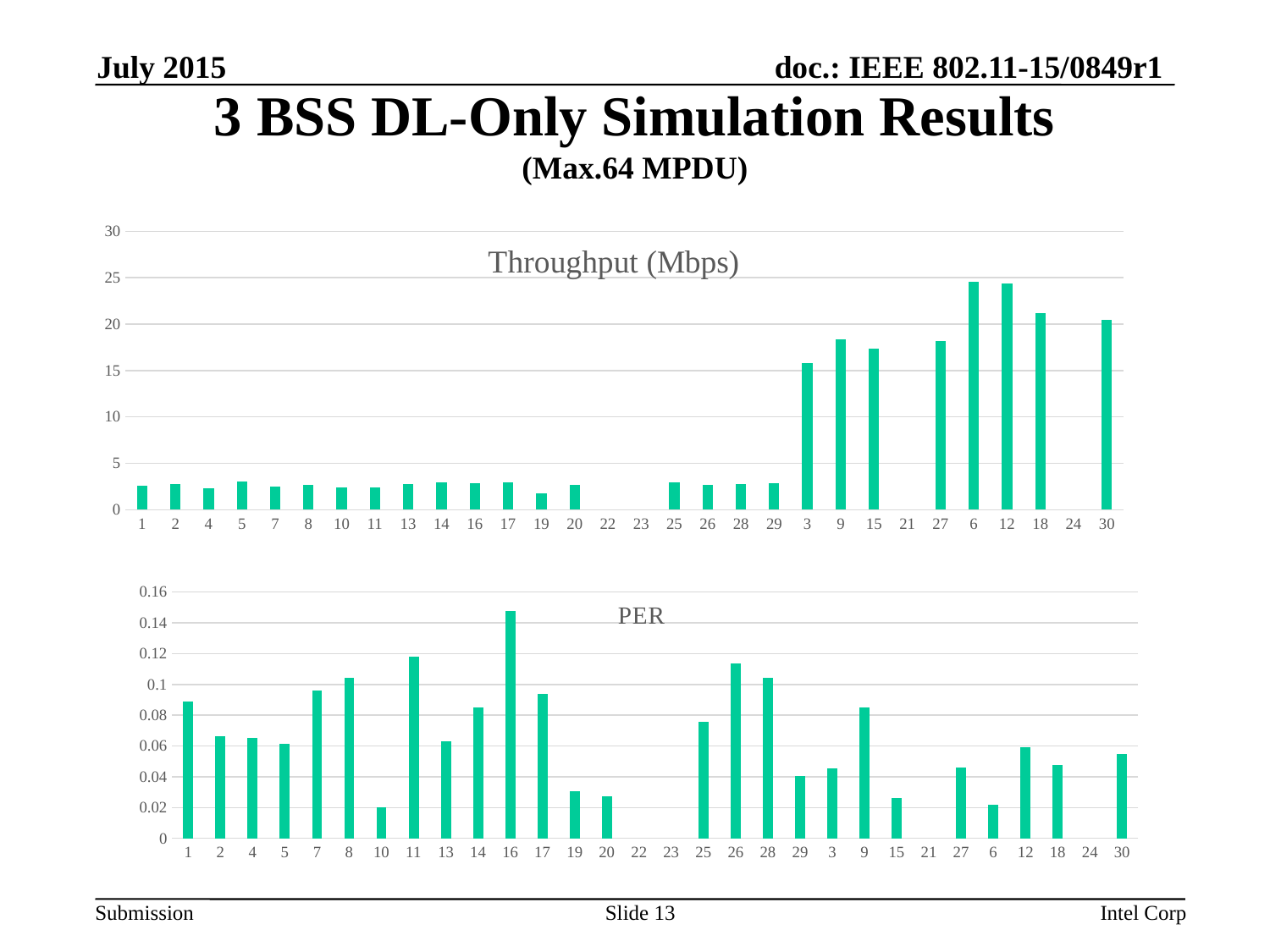
In the PER chart, is the value for category 16 greater or less than 0.14? greater In the PER chart, is the value for category 11 greater or less than 0.1? greater In the Throughput (Mbps) chart, is the value for category 15 greater or less than 20? less What kind of chart is the Throughput (Mbps) chart? bar chart In the Throughput (Mbps) chart, which has the larger value, category 6 or category 1? 6 In the PER chart, which category has the highest value? 16 In the PER chart, which has the larger value, category 26 or category 29? 26 How many categories are labelled on the x axis of the Throughput (Mbps) chart? 30 What is the title of the lower chart on the slide? PER